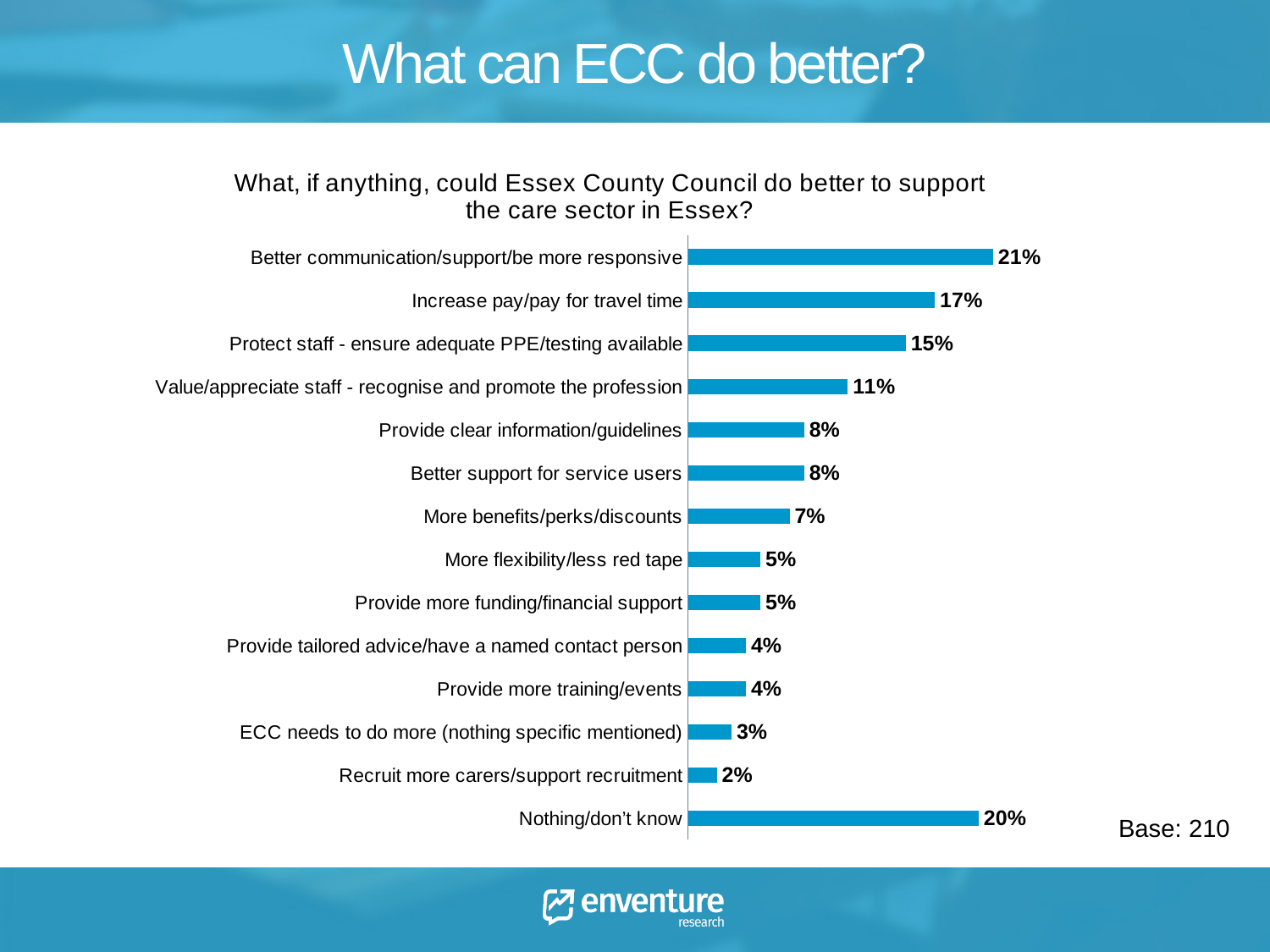
What kind of chart is shown on the slide? Bar chart What is the value for 'More benefits/perks/discounts'? 7% What percentage of respondents said ECC could provide better communication/support/be more responsive? 21% Which category has the highest value in the chart? Better communication/support/be more responsive What is the difference between 'Better communication/support/be more responsive' and 'Increase pay/pay for travel time'? 4% How many categories are shown in the chart? 14 Which category has the lowest value in the chart? Recruit more carers/support recruitment What percentage said 'Nothing/don't know'? 20% Which is larger: 'Protect staff - ensure adequate PPE/testing available' or 'Value/appreciate staff - recognise and promote the profession'? Protect staff - ensure adequate PPE/testing available What is the base (number of respondents) shown on the slide? 210 What is the difference between 'Nothing/don't know' and 'Recruit more carers/support recruitment'? 18% What is the value for 'Increase pay/pay for travel time'? 17%